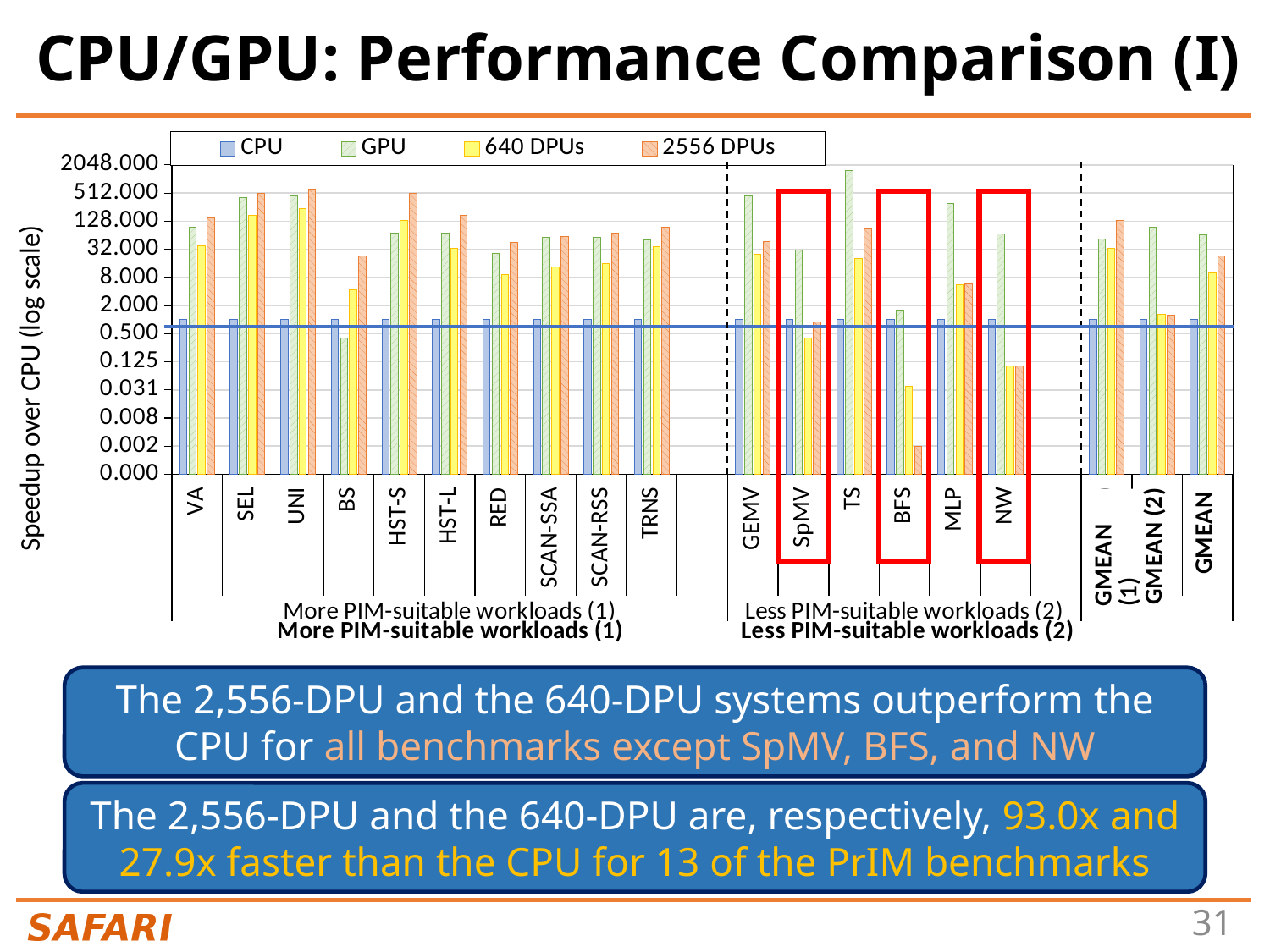
What is the label of the y axis? Speedup over CPU (log scale) Which benchmark has the highest GPU speedup? TS Is the 640 DPUs value for NW greater or less than 0.500? less How many series does the legend list? 4 Which benchmark has the lowest 2556 DPUs speedup? BFS How many benchmark categories (including the GMEAN entries) are shown along the x axis? 19 Is the 2556 DPUs value for BFS greater or less than 0.031? less Is the 2556 DPUs value for HST-S greater or less than 128.000? greater What kind of chart is shown on the slide? bar chart For HST-S, which is larger: the GPU value or the 2556 DPUs value? 2556 DPUs For MLP, which is larger: the GPU value or the 2556 DPUs value? GPU